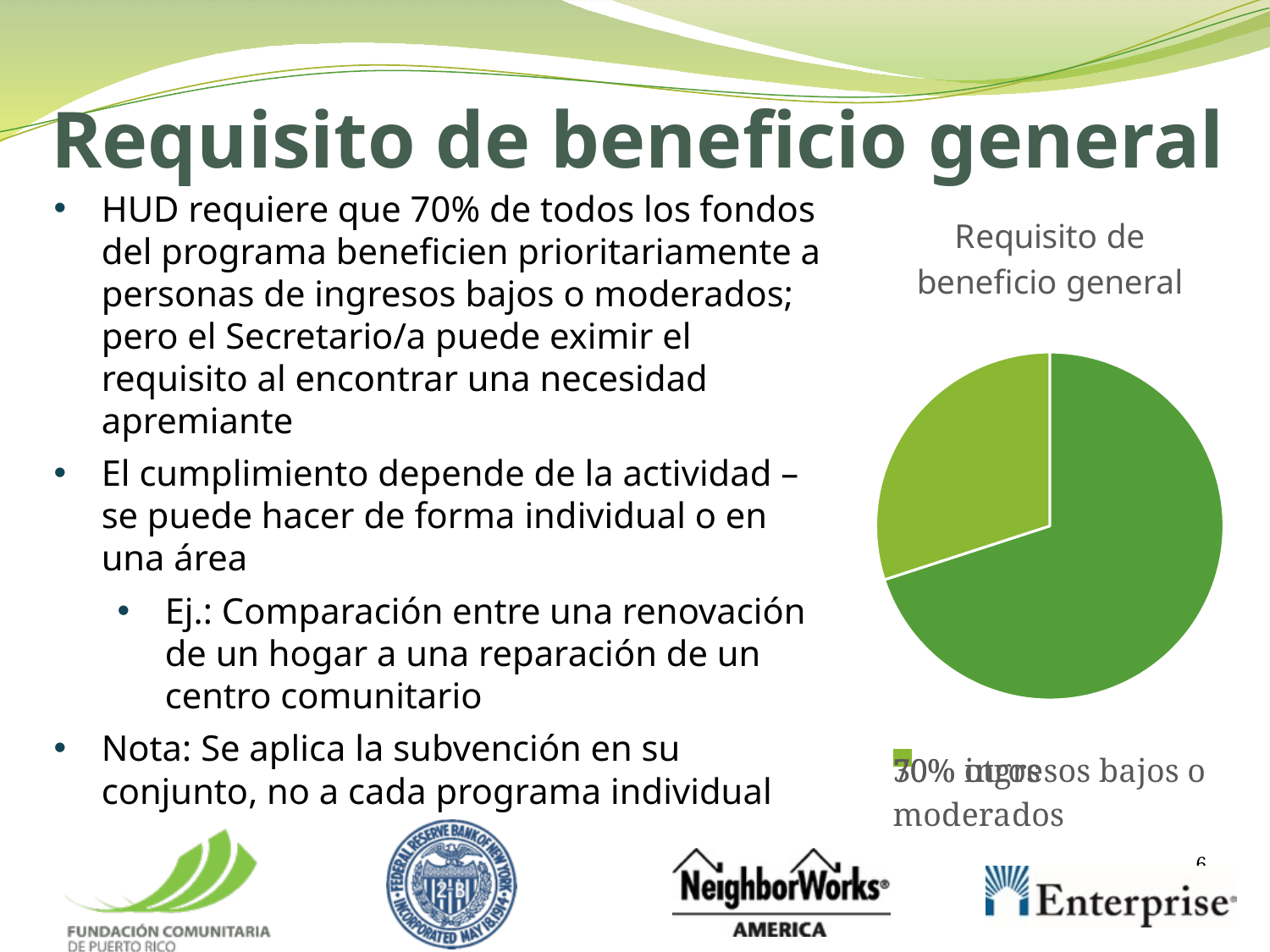
What is the difference between the two shares shown in the legend, 70% and 30%? 40% According to the legend, what share of the pie corresponds to 'ingresos bajos o moderados'? 70% What is the title of the chart? Requisito de beneficio general What colour is the largest slice of the pie chart? dark green According to the legend, what share of the pie corresponds to 'otros'? 30% Is the share of the smaller slice greater or less than 50%? less How many slices does the pie chart have? 2 Which slice is larger, the dark green slice or the light green slice? the dark green slice Is the share of the larger slice greater or less than 50%? greater How many entries does the chart legend list? 2 What kind of chart is shown on the slide? pie chart Which slice of the pie is the smallest? the light green slice